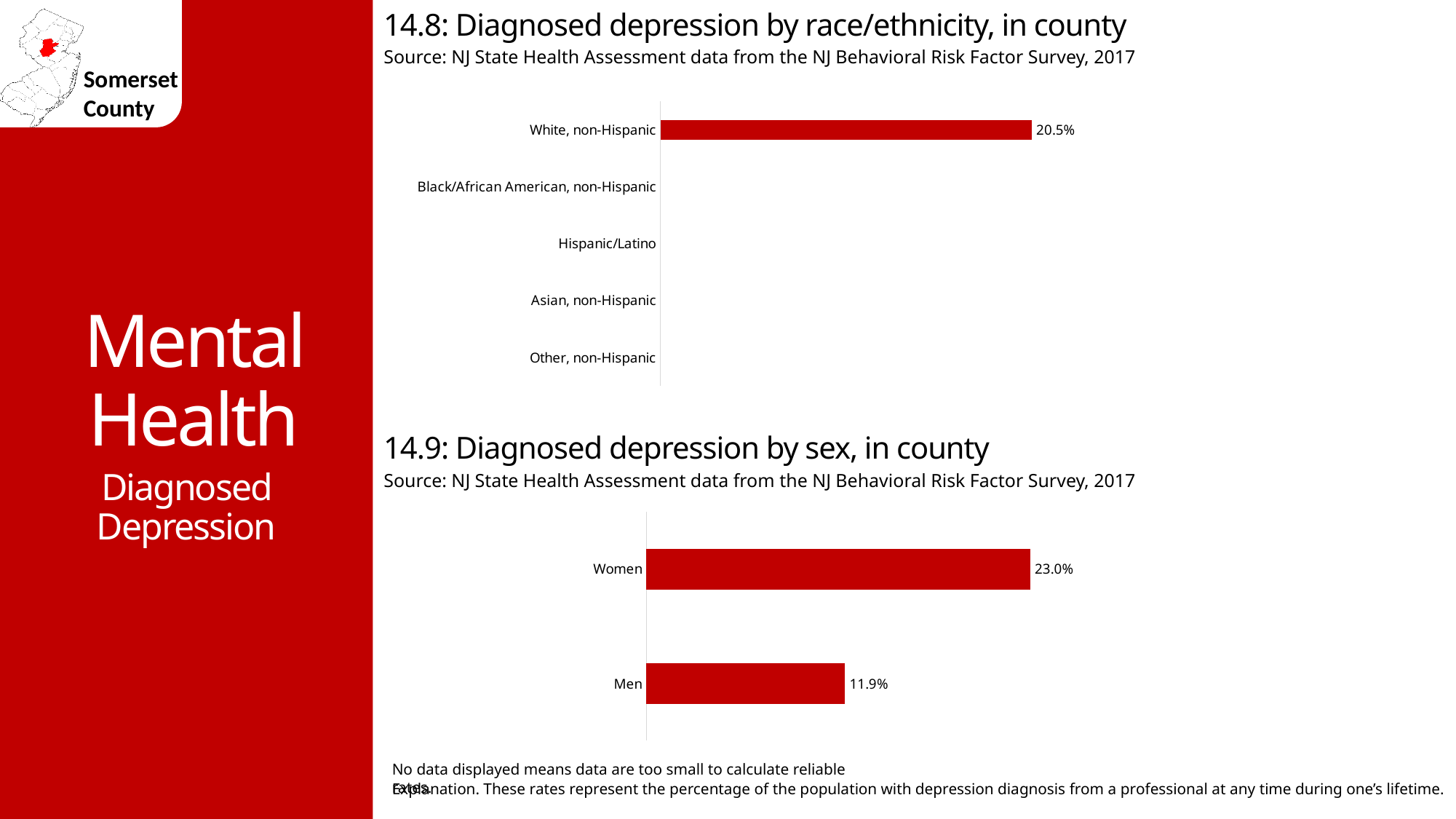
In the chart '14.9: Diagnosed depression by sex, in county', what is the difference between the values for Women and Men? 11.1% In the chart '14.8: Diagnosed depression by race/ethnicity, in county', which category is the only one with a bar displayed? White, non-Hispanic In the chart '14.9: Diagnosed depression by sex, in county', what is the value for Women? 23.0% In the chart '14.9: Diagnosed depression by sex, in county', how many categories are shown? 2 In the chart '14.9: Diagnosed depression by sex, in county', which category has the highest value? Women In the chart '14.8: Diagnosed depression by race/ethnicity, in county', what is the value for White, non-Hispanic? 20.5% In the chart '14.9: Diagnosed depression by sex, in county', what is the value for Men? 11.9% In the chart '14.9: Diagnosed depression by sex, in county', which category has the lowest value? Men In the chart '14.9: Diagnosed depression by sex, in county', is the value for Women or Men larger? Women What kind of chart is '14.8: Diagnosed depression by race/ethnicity, in county'? Bar chart What kind of chart is '14.9: Diagnosed depression by sex, in county'? Bar chart In the chart '14.8: Diagnosed depression by race/ethnicity, in county', how many race/ethnicity categories are listed on the axis? 5